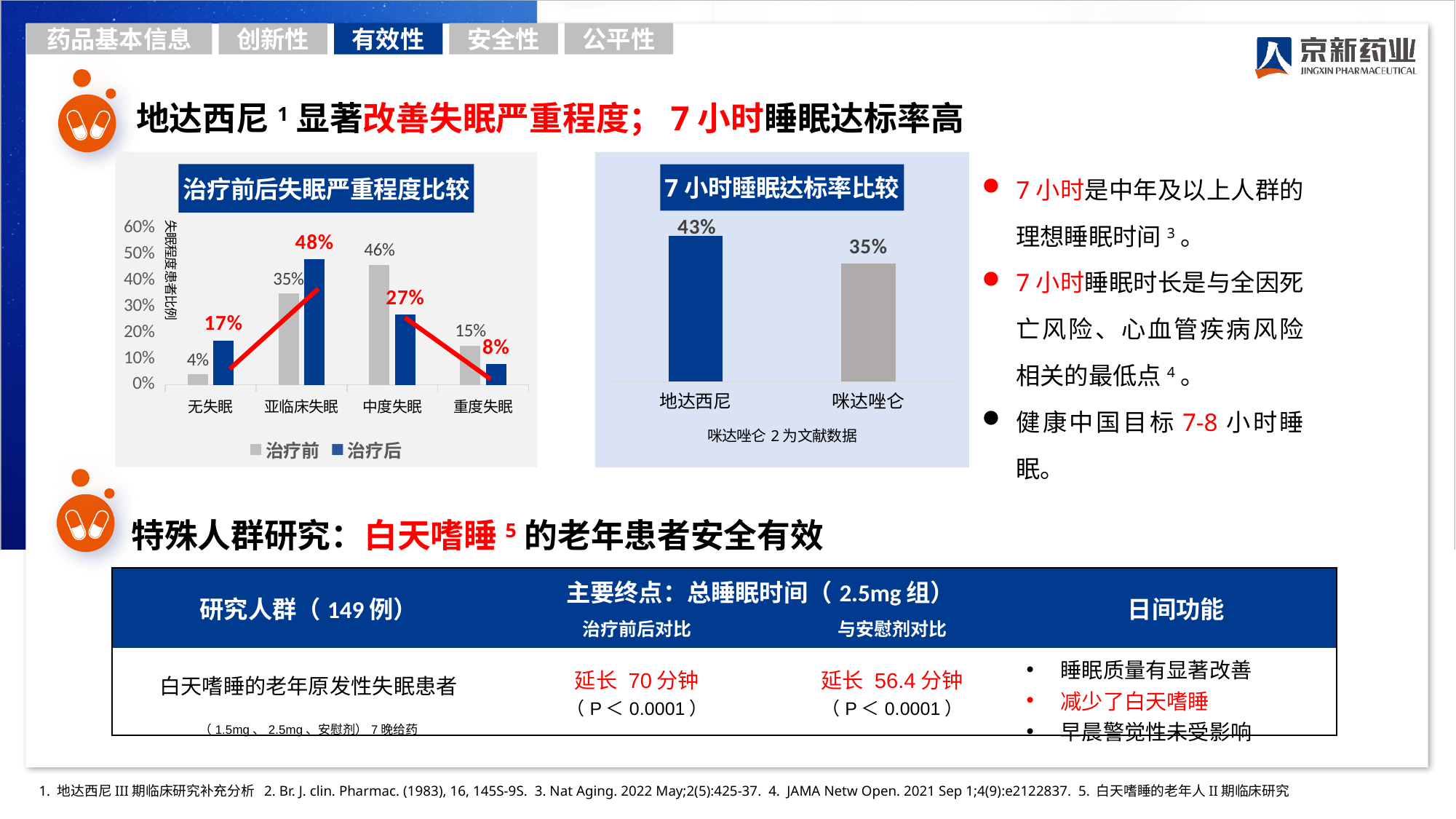
在“治疗前后失眠严重程度比较”图中，治疗后哪个类别的比例最低？ 重度失眠 “治疗前后失眠严重程度比较”图的图例列出了几个系列？ 2 在“治疗前后失眠严重程度比较”图中，中度失眠的治疗前比例是多少？ 46% “7小时睡眠达标率比较”图中，地达西尼与咪达唑仑的达标率相差多少个百分点？ 8个百分点 “7小时睡眠达标率比较”图中，地达西尼的达标率是多少？ 43% 在“治疗前后失眠严重程度比较”图中，重度失眠的治疗前和治疗后哪个比例更高？ 治疗前 在“治疗前后失眠严重程度比较”图中，亚临床失眠的治疗后比例是多少？ 48% “治疗前后失眠严重程度比较”图的横轴共有几个类别？ 4 在“治疗前后失眠严重程度比较”图中，无失眠的治疗后比例比治疗前高多少个百分点？ 13个百分点 “7小时睡眠达标率比较”图是什么类型的图表？ 柱状图（条形图） “治疗前后失眠严重程度比较”图中，治疗后系列用什么颜色表示？ 蓝色 在“治疗前后失眠严重程度比较”图中，治疗前哪个类别的比例最高？ 中度失眠